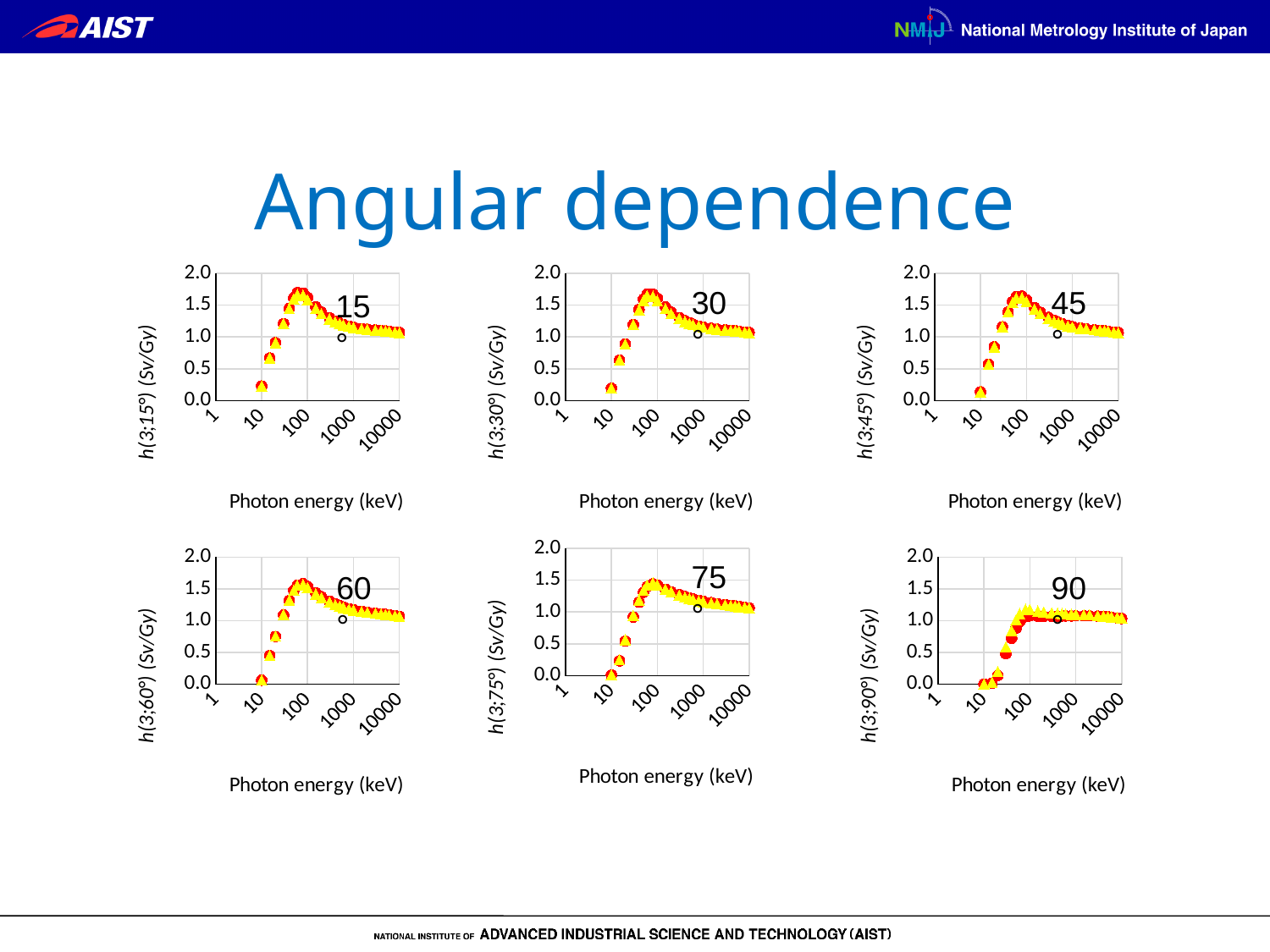
How many charts are shown on the slide? 6 What is the title of the slide above the charts? Angular dependence In the chart labelled 15 (top left), do the values rise or fall as photon energy increases from 100 keV to 10000 keV? fall In the chart labelled 30 (top middle), is the value at 10000 keV greater or less than 1.5? less What is the x-axis label of the charts? Photon energy (keV) Which of the six charts has the lowest peak value? 90 In the chart labelled 90 (bottom right), is the value at 10 keV greater or less than 0.5? less In the chart labelled 90 (bottom right), is the peak value greater or less than 1.5? less In the chart labelled 90 (bottom right), do the values rise or fall as photon energy increases from 10 keV to 100 keV? rise What is the highest tick value shown on the y-axis of the charts? 2.0 What kind of chart is used in each of the six panels on the slide? scatter chart